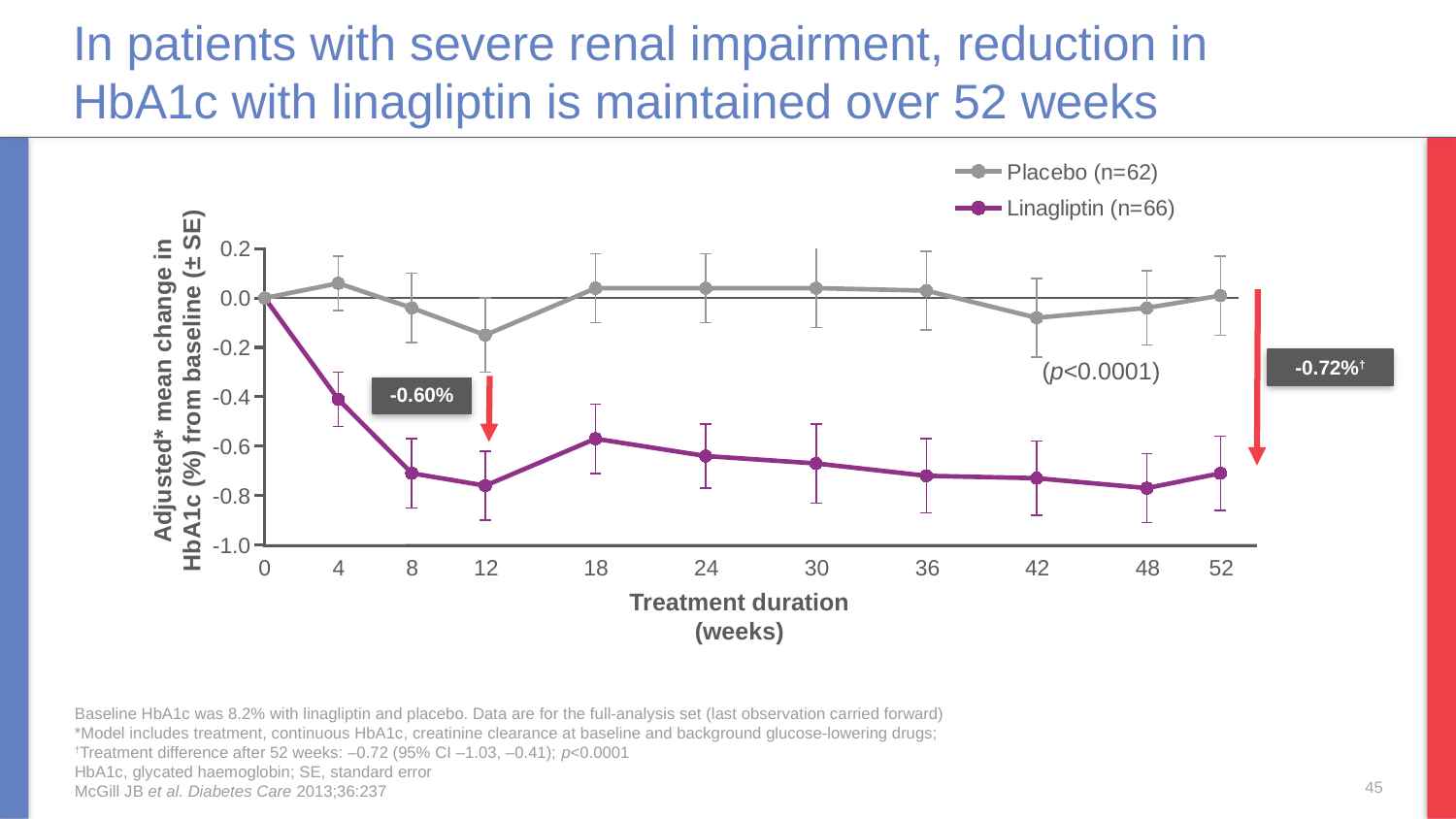
What value is printed in the label with the arrow at week 12? -0.60% What kind of chart is shown on the slide? line chart At week 52, which series has the higher value, Placebo or Linagliptin? Placebo What is the sample size shown in the legend for the Linagliptin group? n=66 How many series does the legend list? 2 Does the Linagliptin line rise or fall from week 0 to week 12? fall What value is printed in the label with the arrow at week 52? -0.72% What is the sample size shown in the legend for the Placebo group? n=62 Is the value for Linagliptin at week 48 greater or less than -0.6? less Is the value for Placebo at week 52 greater or less than -0.2? greater Is the value for Linagliptin at week 12 greater or less than -0.6? less How many time points are plotted along the x axis? 11